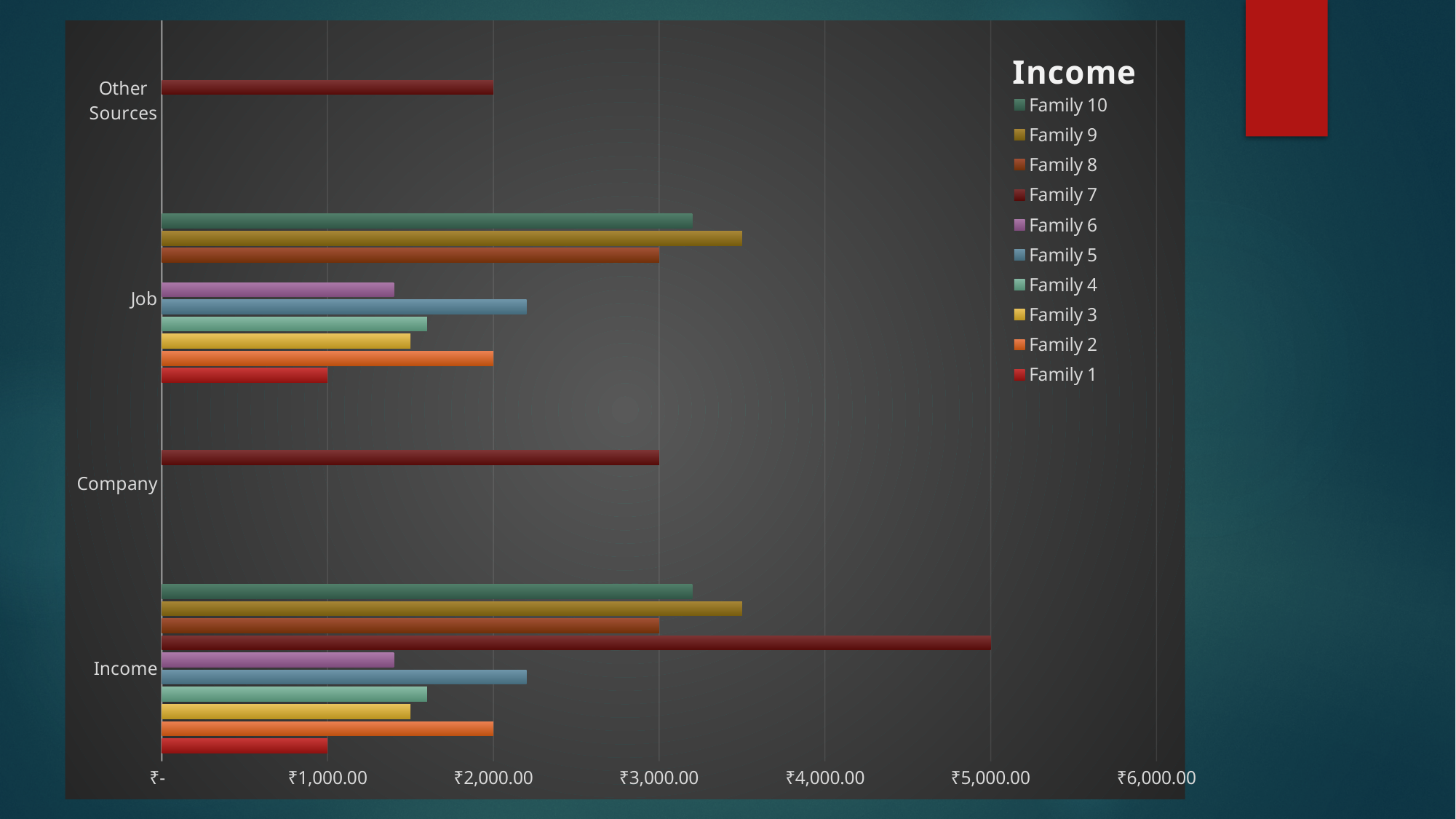
What is the title of the chart? Income What is the value for Family 7 in the Income category? ₹5,000.00 What is the value for Family 7 in the Other Sources category? ₹2,000.00 How many series does the legend list? 10 What kind of chart is shown on the slide? bar chart How many categories are shown on the vertical axis? 4 Which family has the highest value in the Income category? Family 7 Which is larger in the Income category: Family 7 or Family 9? Family 7 Is the value for Family 9 in the Job category greater or less than ₹3,000.00? greater What is the difference between Family 7's Income value and Family 8's Income value? ₹2,000.00 What is the value for Family 7 in the Company category? ₹3,000.00